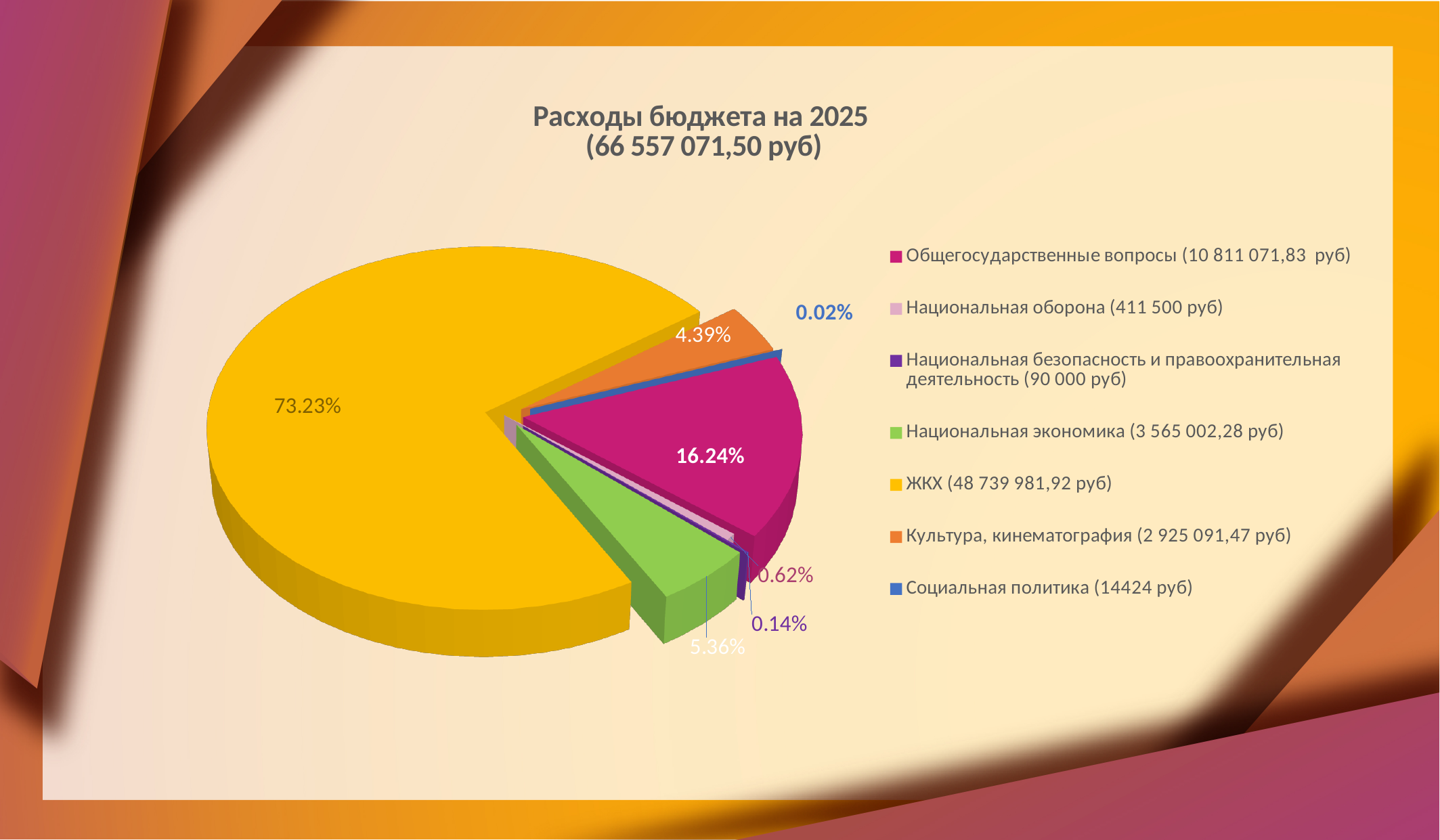
How many categories does the legend list? 7 What kind of chart is shown on the slide? Pie chart What share of the pie does Социальная политика take? 0.02% What share of the pie does Национальная экономика take? 5.36% What share of the pie does Общегосударственные вопросы take? 16.24% Which category has the smallest share of the pie? Социальная политика What is the title of the chart? Расходы бюджета на 2025 (66 557 071,50 руб) Which has the larger share: Национальная экономика or Культура, кинематография? Национальная экономика Which category has the largest share of the pie? ЖКХ What is the difference in percentage points between the ЖКХ share and the Общегосударственные вопросы share? 56.99